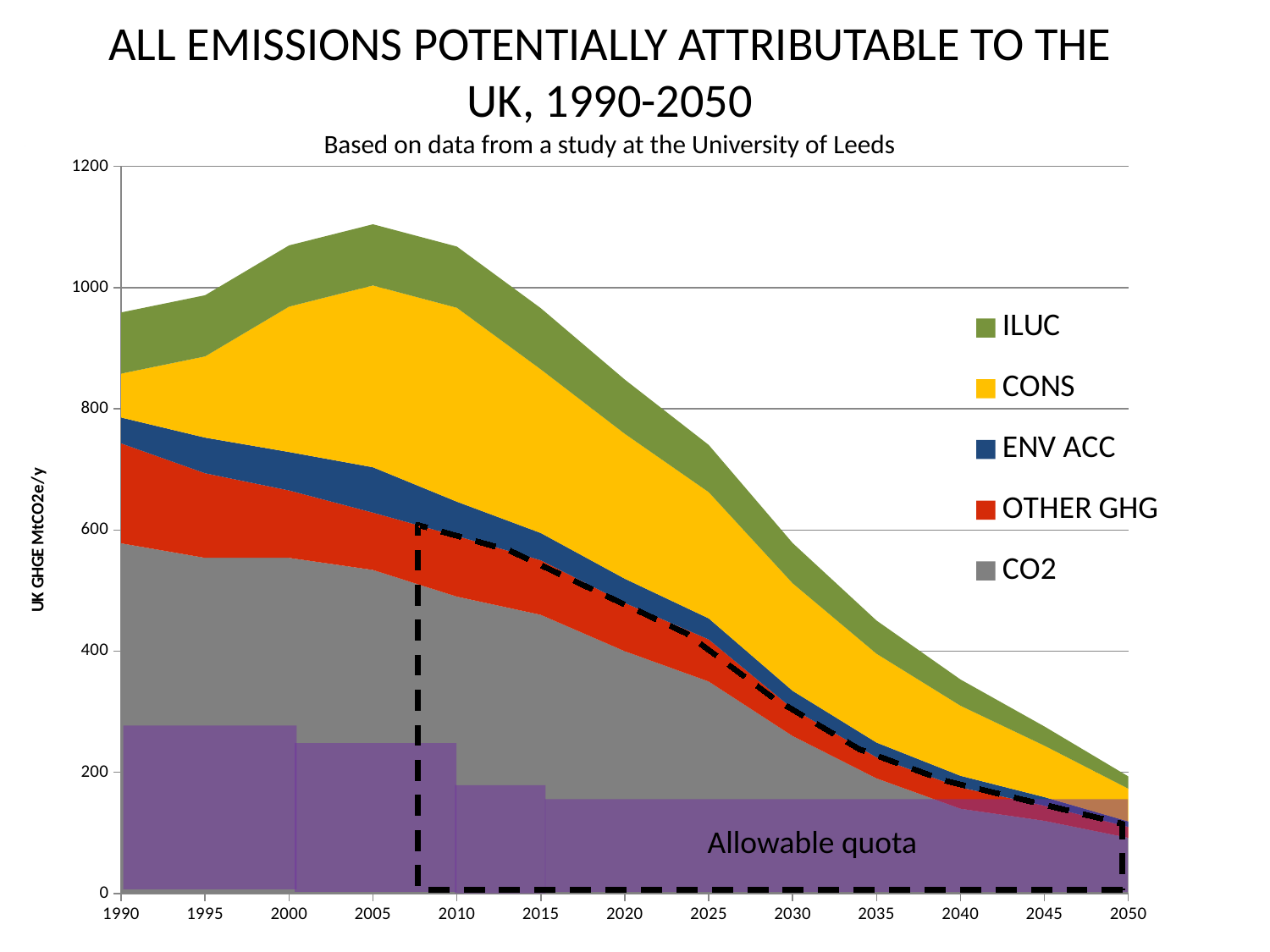
Is the total stacked value in 1990 greater or less than 1000? less In which year is the total of all stacked emissions highest? 2005 What is the label on the y axis? UK GHGE MtCO2e/y Is the total stacked value in 2005 greater or less than 1000? greater Do the total stacked emissions rise or fall between 2005 and 2050? fall Which year has the larger total stacked value, 2000 or 2030? 2000 How many years are marked along the x axis? 13 What kind of chart is shown on the slide? Stacked area chart In which year is the total of all stacked emissions lowest? 2050 How many series does the legend list? 5 Is the total stacked value in 2035 greater or less than 400? greater